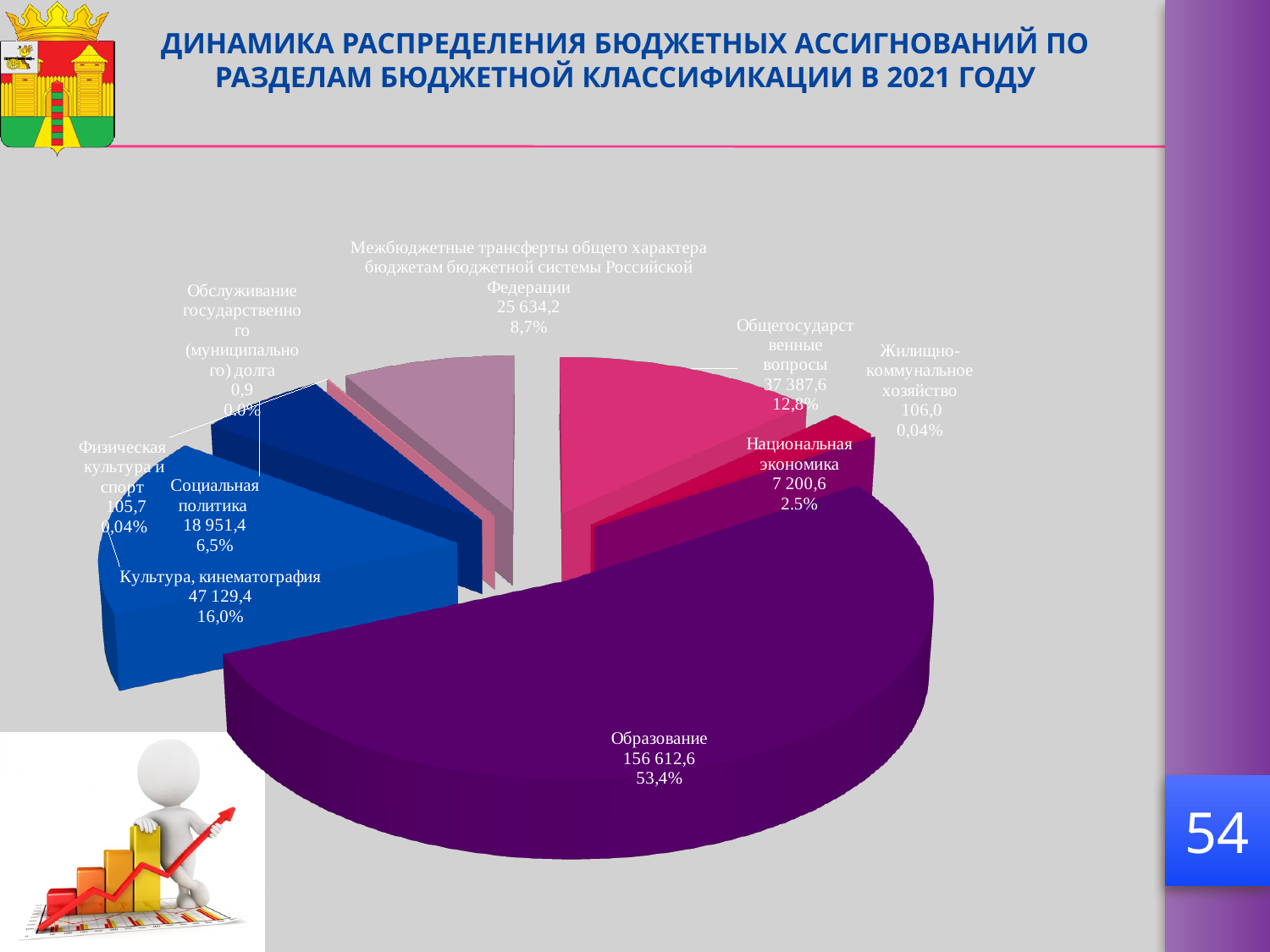
What is the value shown for Образование? 156 612,6 How many categories (slices) does the pie chart show? 9 Which category has the largest share of the pie? Образование What is the value shown for Национальная экономика? 7 200,6 What is the value shown for Социальная политика? 18 951,4 What type of chart is shown on the slide? pie chart Which is larger: Культура, кинематография or Социальная политика? Культура, кинематография What is the difference between the values for Культура, кинематография and Социальная политика? 28 178,0 What share of the pie does Общегосударственные вопросы represent? 12,8% What is the value shown for Культура, кинематография? 47 129,4 Which category has the smallest value in the pie chart? Обслуживание государственного (муниципального) долга What share of the pie does Образование represent? 53,4%